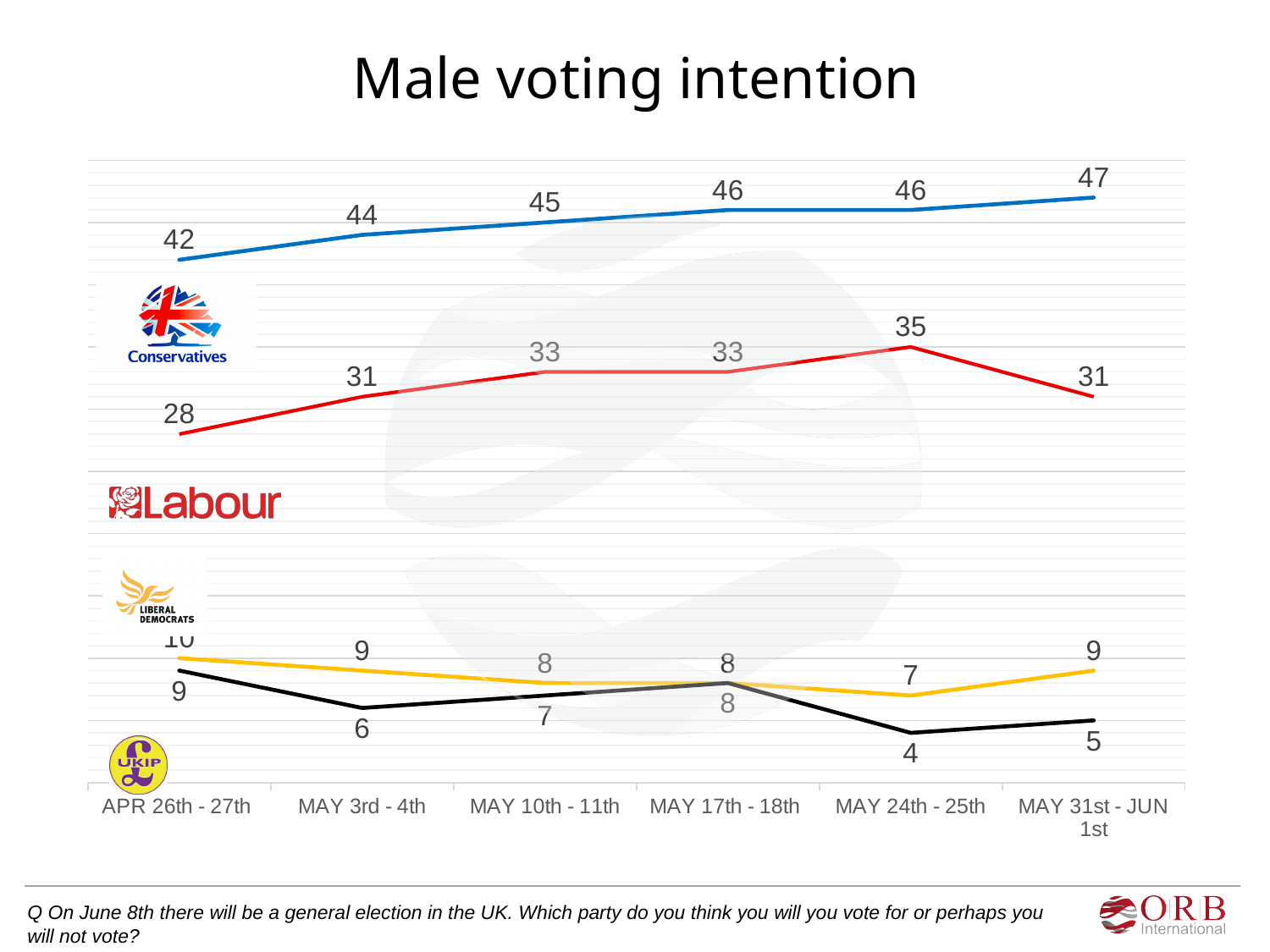
Does the Conservatives line rise or fall from APR 26th - 27th to MAY 31st - JUN 1st? Rises At which date is the UKIP value lowest? MAY 24th - 25th What kind of chart is shown on the slide? Line chart How many polling dates are shown on the x axis? 6 What is the Conservatives value for MAY 31st - JUN 1st? 47 Which party has the higher value at MAY 31st - JUN 1st, Liberal Democrats or UKIP? Liberal Democrats What is the UKIP value for MAY 3rd - 4th? 6 How many parties are plotted on the chart? 4 What is the Labour value for MAY 24th - 25th? 35 What is the Liberal Democrats value for MAY 24th - 25th? 7 What is the difference between the Conservatives and Labour values at APR 26th - 27th? 14 At which date does Labour reach its highest value? MAY 24th - 25th